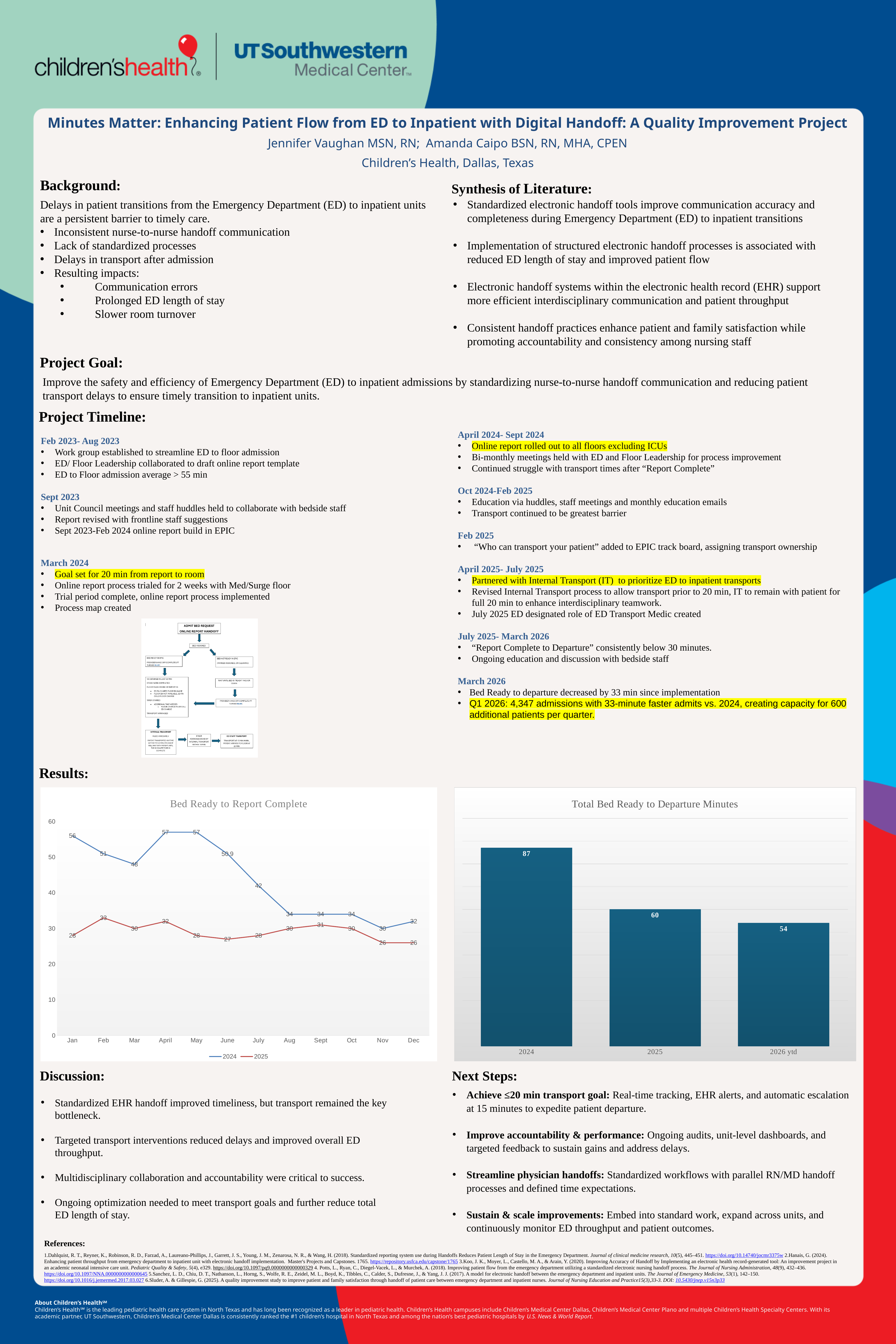
In the 'Bed Ready to Report Complete' chart, what is the 2024 value for June? 50.9 What kind of chart is 'Total Bed Ready to Departure Minutes'? bar chart In the 'Total Bed Ready to Departure Minutes' chart, what is the difference between the 2024 and 2025 values? 27 In the 'Bed Ready to Report Complete' chart, which month has the lowest 2024 value? Nov In the 'Total Bed Ready to Departure Minutes' chart, do the values rise or fall from 2024 to 2026 ytd? fall In the 'Bed Ready to Report Complete' chart, what is the 2025 value for Feb? 33 In the 'Total Bed Ready to Departure Minutes' chart, what is the value for 2026 ytd? 54 In the 'Bed Ready to Report Complete' chart, which is larger for April: the 2024 value or the 2025 value? 2024 In the 'Total Bed Ready to Departure Minutes' chart, which year has the highest value? 2024 In the 'Total Bed Ready to Departure Minutes' chart, what is the value for 2024? 87 In the 'Bed Ready to Report Complete' chart, what is the difference between the 2024 and 2025 values for Jan? 28 How many series does the legend of the 'Bed Ready to Report Complete' chart list? 2